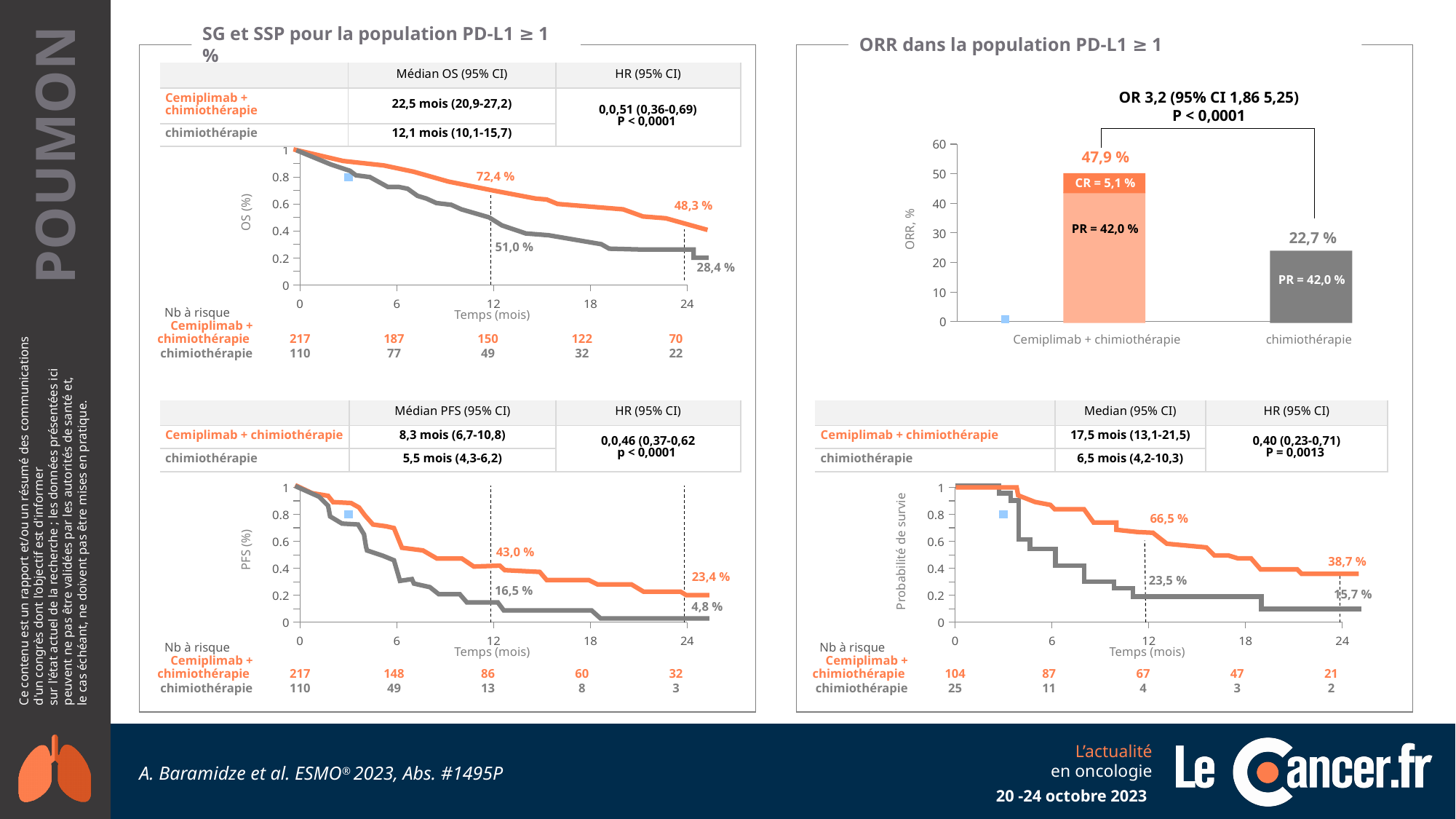
What kind of chart is the ORR chart in the top right? Bar chart In the PFS curve (bottom left), which curve has the higher labelled value at 24 months, Cemiplimab + chimiothérapie or chimiothérapie? Cemiplimab + chimiothérapie In the PFS curve (bottom left), what is the PFS value labelled at 12 months for the chimiothérapie curve? 16,5 % In the OS curve (top left), what is the OS value labelled at 12 months for the Cemiplimab + chimiothérapie curve? 72,4 % In the bottom-right survival probability curve, what is the value labelled at 12 months for the Cemiplimab + chimiothérapie curve? 66,5 % In the ORR bar chart (top right), what is the CR value shown for Cemiplimab + chimiothérapie? CR = 5,1 % In the bottom-right survival probability curve, do the curves rise or fall as time increases along the x axis? Fall In the ORR bar chart (top right), what is the ORR value for Cemiplimab + chimiothérapie? 47,9 % In the OS curve (top left), what is the difference between the two curves' labelled values at 24 months? 19,9 % In the ORR bar chart (top right), what is the ORR value for chimiothérapie? 22,7 % In the OS curve (top left), what is the OS value labelled at 24 months for the chimiothérapie curve? 28,4 % In the ORR bar chart (top right), what is the difference in ORR between Cemiplimab + chimiothérapie and chimiothérapie? 25,2 %